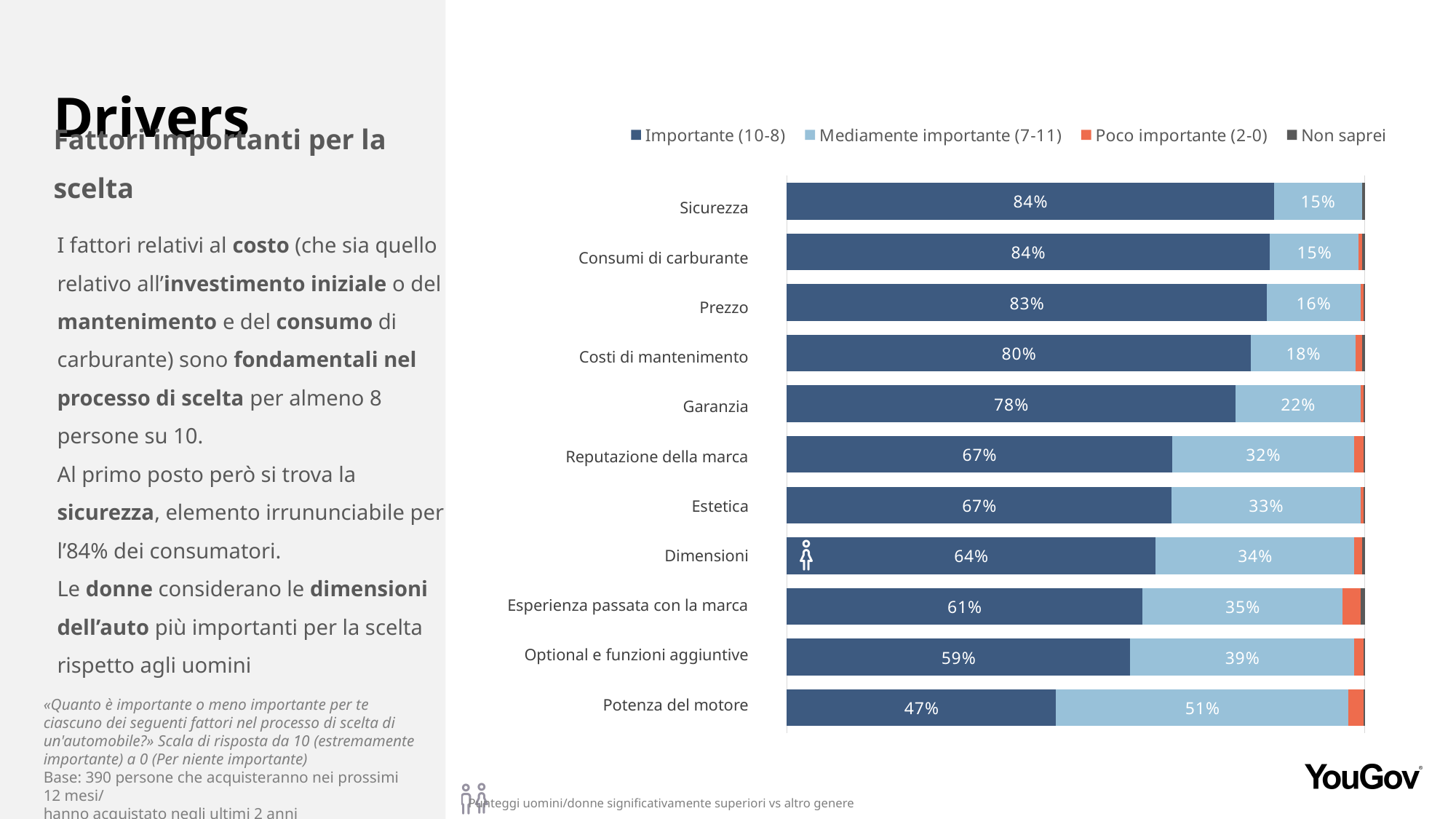
What is the difference between the Importante (10-8) values for Garanzia and Dimensioni? 14% Which category has the lowest Importante (10-8) value? Potenza del motore What percentage of respondents rate Sicurezza as Importante (10-8)? 84% What kind of chart is shown on the slide? Stacked bar chart What is the Importante (10-8) value for Optional e funzioni aggiuntive? 59% What is the Importante (10-8) value for Esperienza passata con la marca? 61% Which category has the highest Mediamente importante (7-11) value? Potenza del motore What is the Mediamente importante (7-11) value for Potenza del motore? 51% Which has a higher Importante (10-8) value, Prezzo or Reputazione della marca? Prezzo How many categories are shown in the chart? 11 Which legend entry is shown in red/orange? Poco importante (2-0) How many series does the legend list? 4